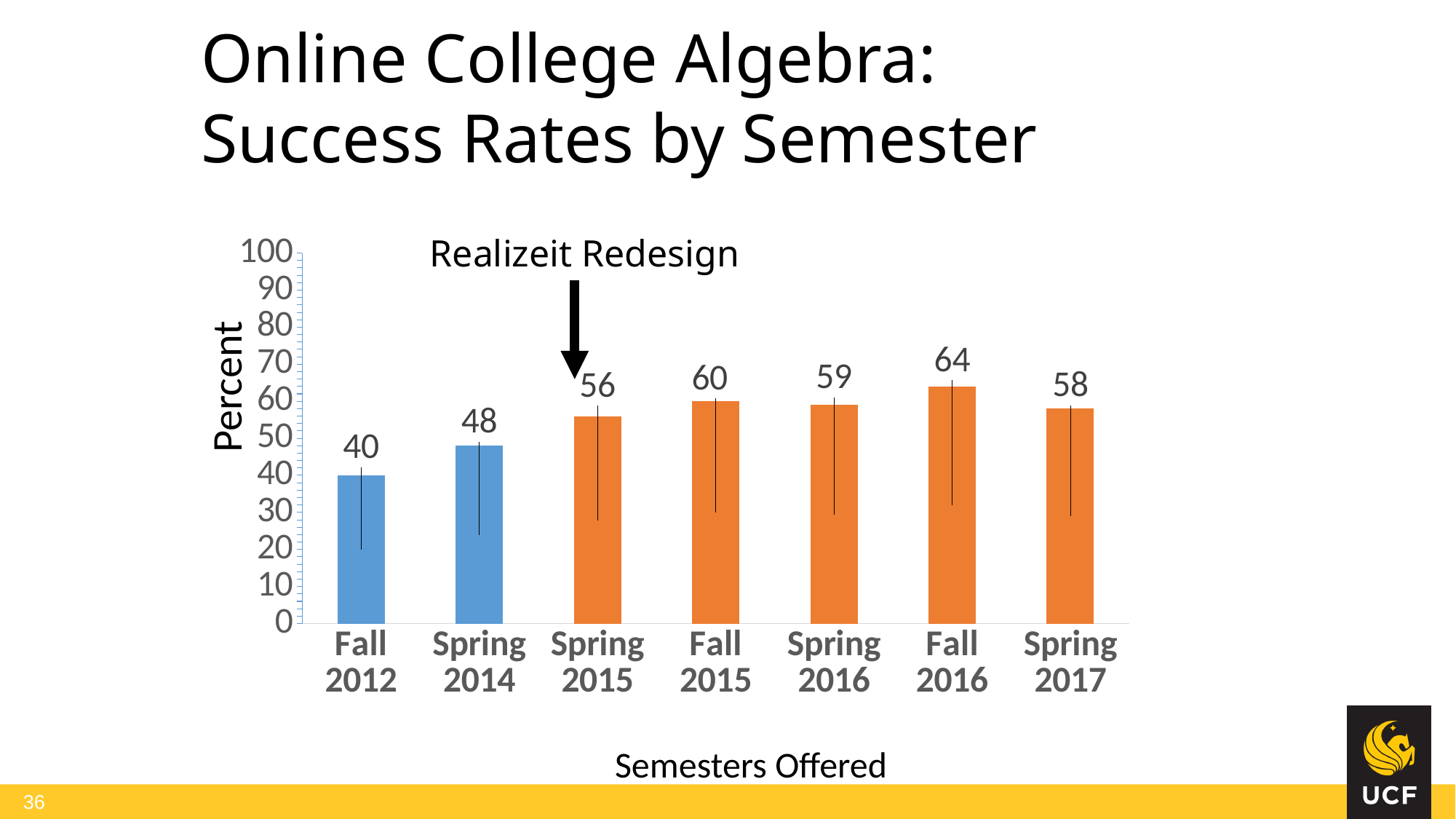
What is the difference between the success rates for Fall 2016 and Fall 2012? 24 What is the success rate for Fall 2012? 40 What is the difference between the success rates for Spring 2015 and Spring 2014? 8 What is the success rate for Spring 2017? 58 How many semesters are shown on the x axis? 7 Which has a higher success rate, Fall 2015 or Spring 2016? Fall 2015 What label is shown above the arrow pointing at the Spring 2015 bar? Realizeit Redesign What is the success rate for Fall 2016? 64 Which semester has the lowest success rate? Fall 2012 Which semester has the highest success rate? Fall 2016 What kind of chart is shown on the slide? bar chart Is the value for Spring 2014 greater or less than 50? less